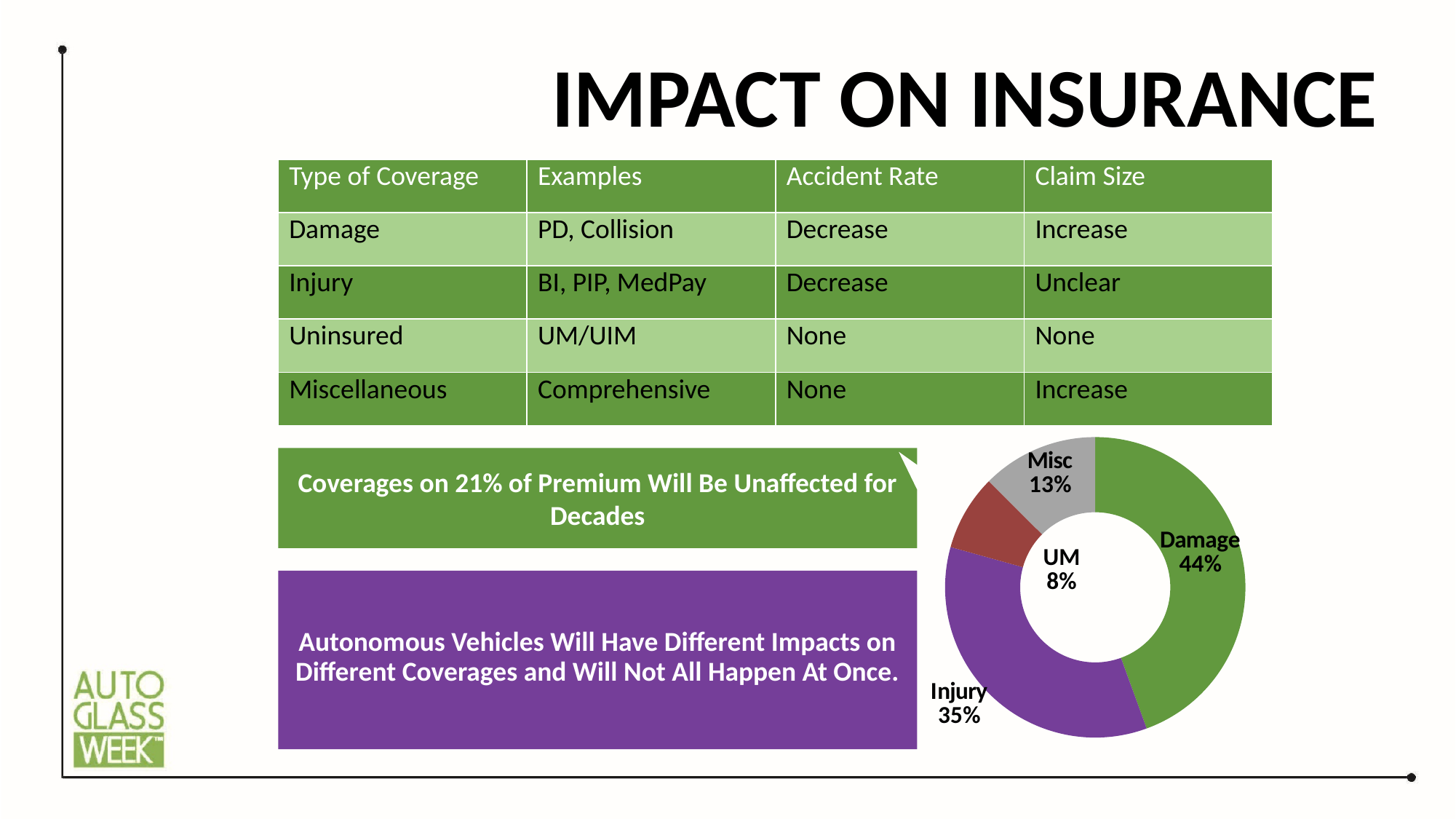
What is the combined share of Misc and UM in the donut chart? 21% Which category has the smallest share in the donut chart? UM Which has a larger share in the donut chart, Misc or UM? Misc How many categories are shown in the donut chart? 4 What type of chart is shown on the slide? Donut chart What share of the donut chart does UM represent? 8% Which category has the largest share in the donut chart? Damage What share of the donut chart does Injury represent? 35% What is the difference in percentage points between the Damage and Injury shares in the donut chart? 9 What share of the donut chart does Misc represent? 13% What share of the donut chart does Damage represent? 44% What colour is the Injury segment in the donut chart? Purple